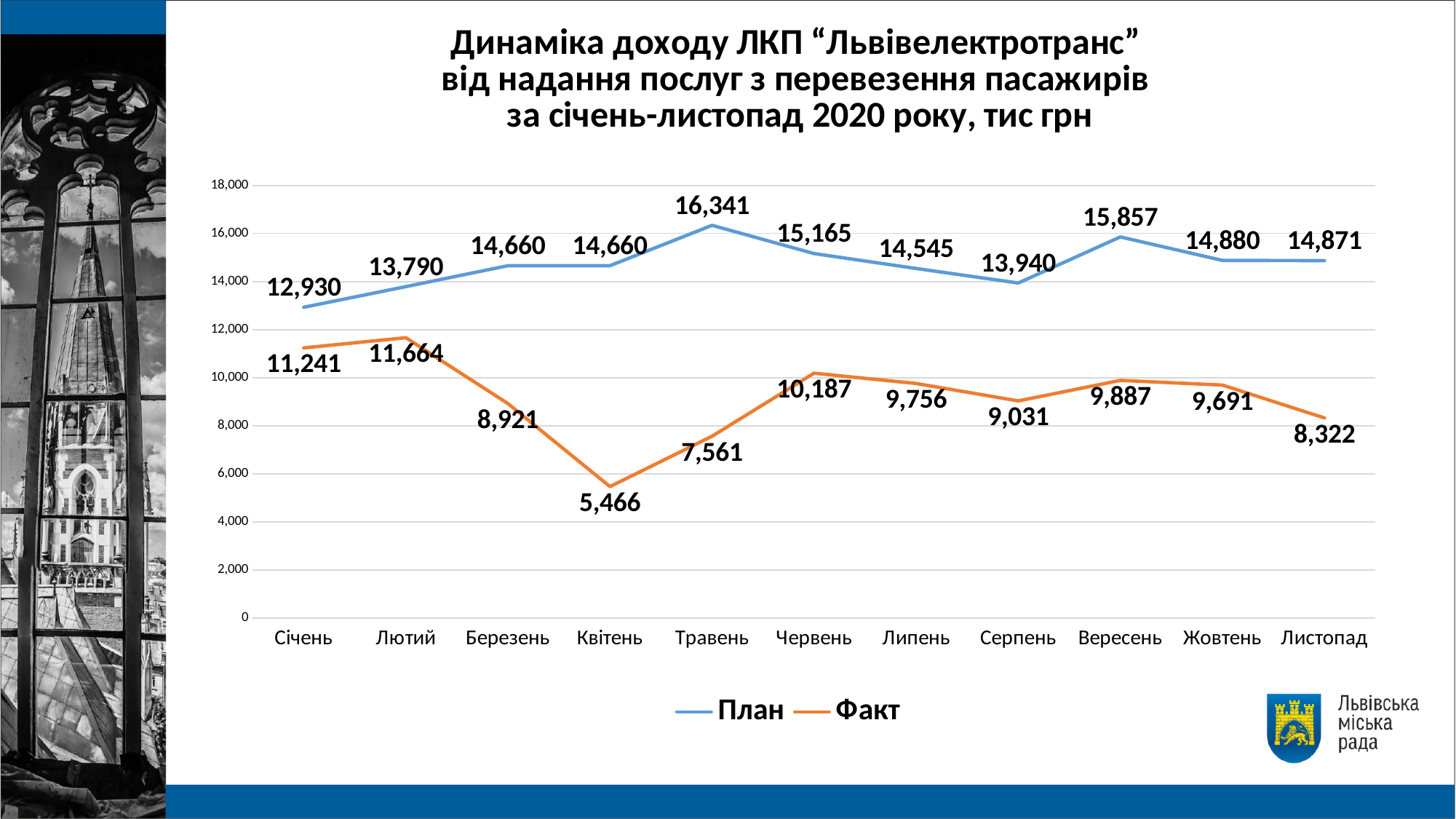
What is the difference between the План and Факт values for Квітень? 9,194 What is the Факт value for Квітень? 5,466 What is the План value for Травень? 16,341 In which month is the План series highest? Травень Which is larger, the Факт value for Червень or the Факт value for Вересень? Червень How many months are shown on the x axis? 11 How many series does the legend list? 2 What kind of chart is shown on the slide? line chart In which month is the Факт series lowest? Квітень Does the Факт series rise or fall from Вересень to Листопад? fall What is the Факт value for Листопад? 8,322 What is the difference between the Факт values for Лютий and Березень? 2,743